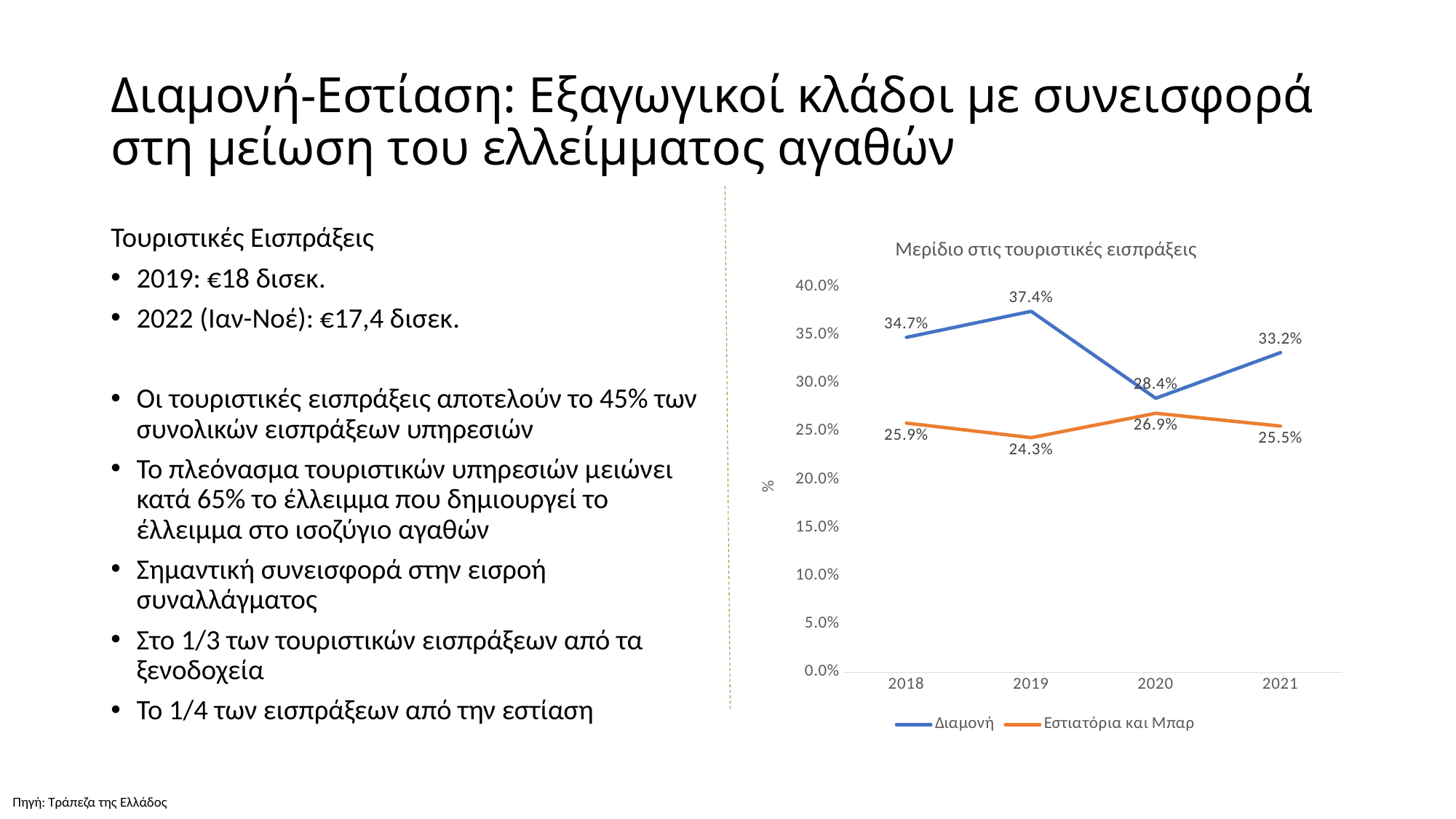
In which year is the Διαμονή series at its lowest? 2020 What is the value for Διαμονή in 2019? 37.4% In which year is the Εστιατόρια και Μπαρ series at its highest? 2020 How many years are shown on the x axis? 4 What is the title of the chart? Μερίδιο στις τουριστικές εισπράξεις What is the difference between Διαμονή and Εστιατόρια και Μπαρ in 2019? 13.1% How many series does the legend list? 2 Does the Διαμονή series rise or fall from 2019 to 2020? fall What is the value for Εστιατόρια και Μπαρ in 2020? 26.9% What kind of chart is shown on the slide? line chart What is the value for Διαμονή in 2021? 33.2% Which series has the larger value in 2018, Διαμονή or Εστιατόρια και Μπαρ? Διαμονή